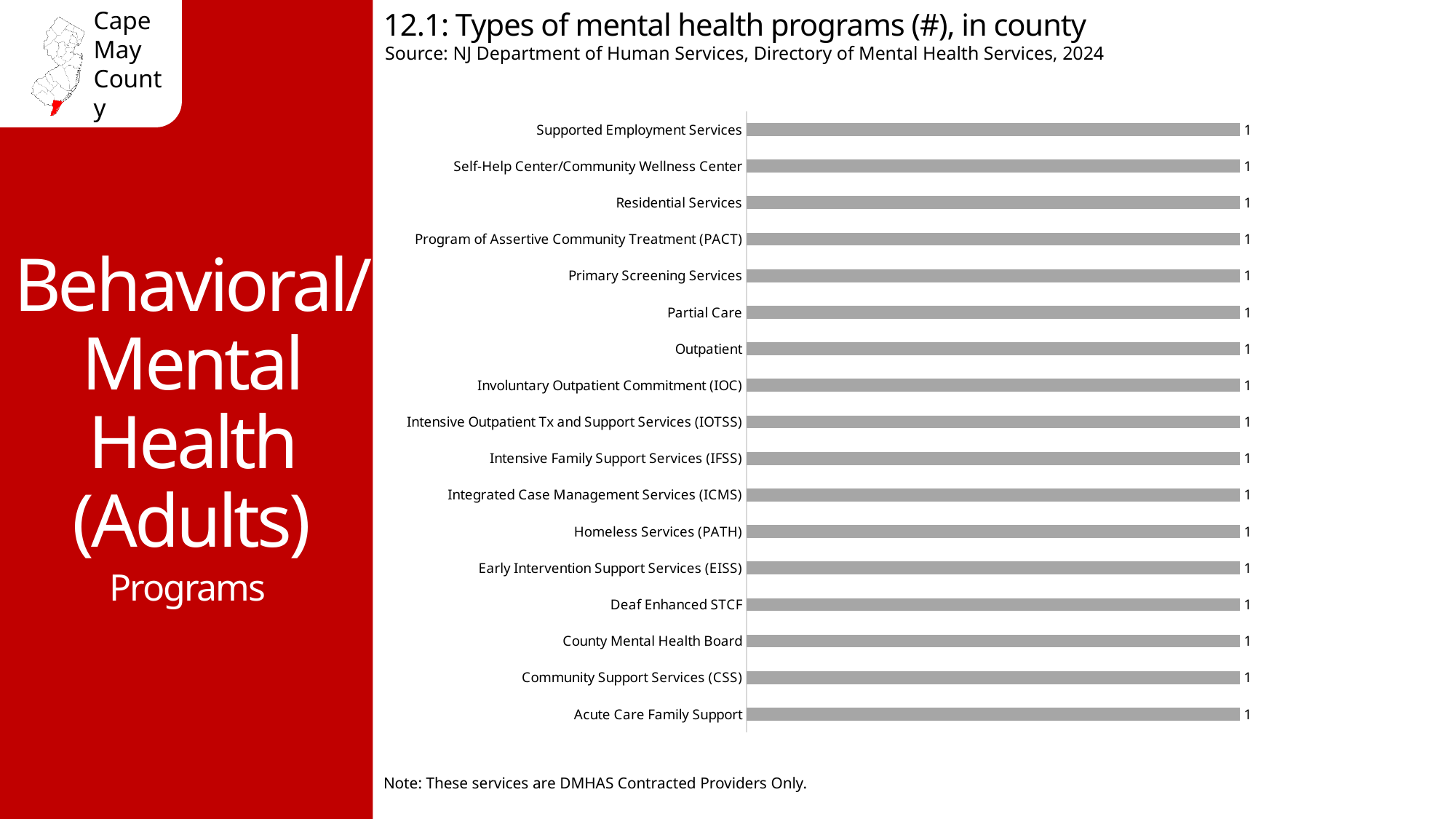
What is the difference between the value for Outpatient and the value for Residential Services? 0 How many types of mental health programs are listed in the chart? 17 What is the value for Partial Care? 1 What kind of chart is shown on the slide? bar chart What is the value for Deaf Enhanced STCF? 1 What is the difference between the value for County Mental Health Board and the value for Community Support Services (CSS)? 0 What is the value for Program of Assertive Community Treatment (PACT)? 1 What is the value for Acute Care Family Support? 1 What is the title of the chart? 12.1: Types of mental health programs (#), in county What is the value for Homeless Services (PATH)? 1 Which category is listed at the top of the chart? Supported Employment Services